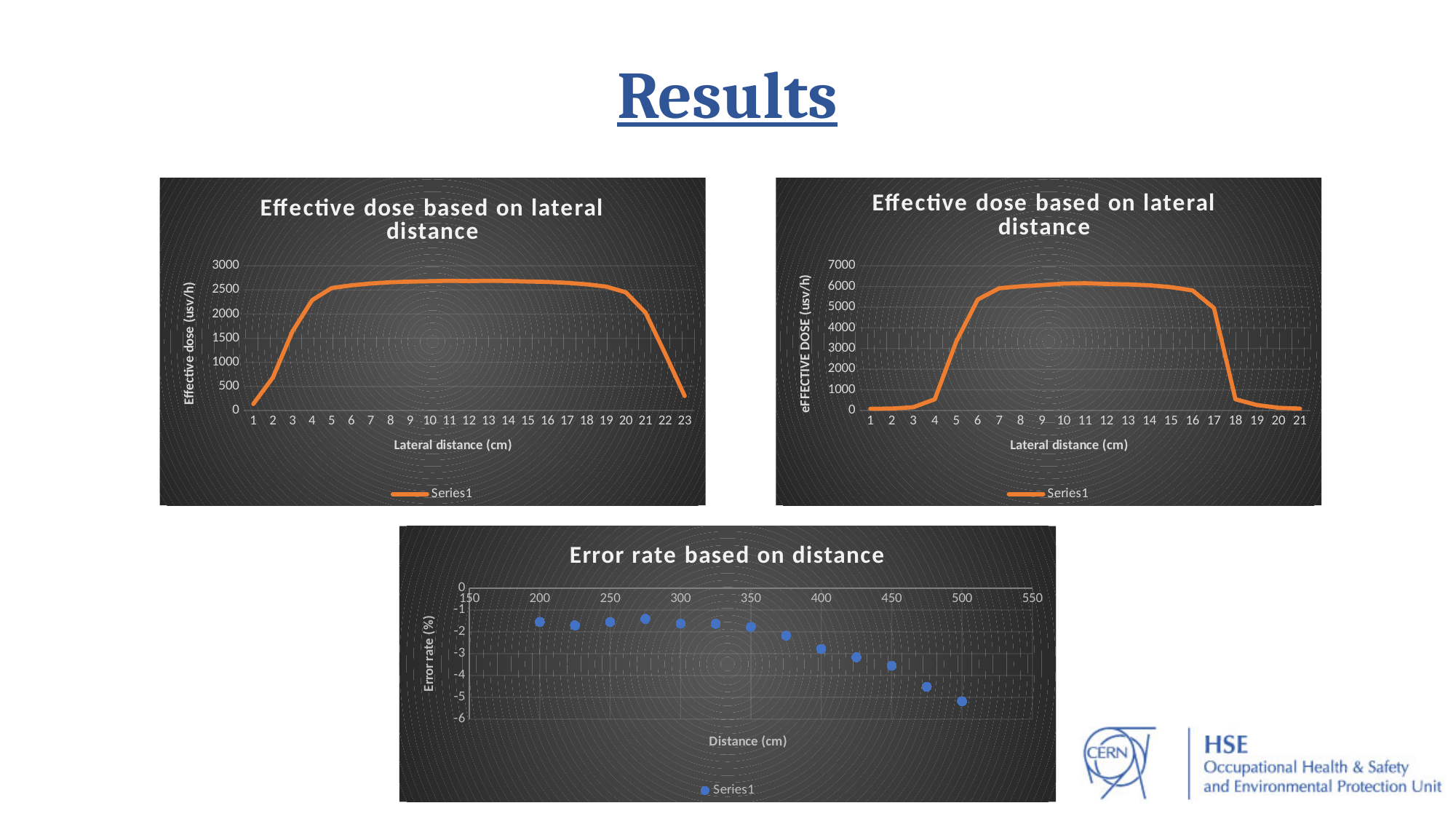
In the 'Error rate based on distance' chart, is the error rate at a distance of 500 cm greater or less than -5? less How many series does the legend of the 'Error rate based on distance' chart list? 1 In the left-hand 'Effective dose based on lateral distance' chart, is the value at lateral distance 12 greater or less than 2500? greater In the 'Error rate based on distance' chart, how many data points are plotted? 13 In the left-hand 'Effective dose based on lateral distance' chart, how many lateral distance points are plotted on the x axis? 23 In the right-hand 'Effective dose based on lateral distance' chart, how many lateral distance points are plotted on the x axis? 21 In the 'Error rate based on distance' chart, does the error rate rise or fall as distance increases from 350 cm to 500 cm? fall What kind of chart is the 'Error rate based on distance' chart? scatter chart In the left-hand 'Effective dose based on lateral distance' chart, is the value at lateral distance 1 greater or less than 500? less What kind of chart is the left-hand 'Effective dose based on lateral distance' chart? line chart